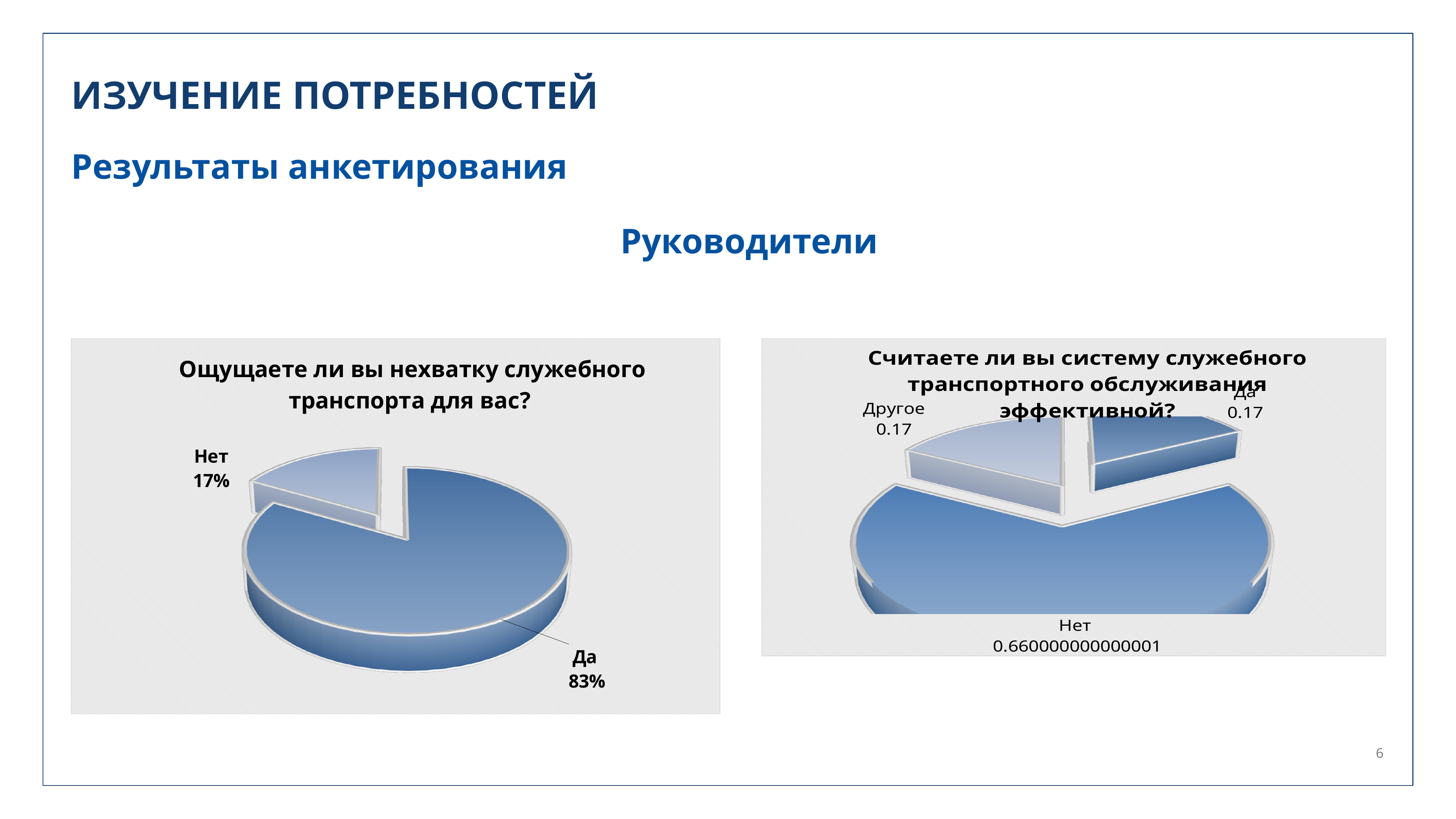
How many slices does the right pie chart have? 3 In the right chart, which slice is the largest? Нет What is the title of the left chart? Ощущаете ли вы нехватку служебного транспорта для вас? How many slices does the left pie chart have? 2 In the right chart ("Считаете ли вы систему служебного транспортного обслуживания эффективной?"), what value is labelled for "Другое"? 0.17 In the left chart ("Ощущаете ли вы нехватку служебного транспорта для вас?"), what share is labelled for "Нет"? 17% What type of chart is the left chart on the slide? Pie chart In the left chart ("Ощущаете ли вы нехватку служебного транспорта для вас?"), what share is labelled for "Да"? 83% In the right chart ("Считаете ли вы систему служебного транспортного обслуживания эффективной?"), what value is labelled for "Нет"? 0.660000000000001 In the left chart, which slice is the largest? Да In the right chart, which is larger: the "Нет" slice or the "Да" slice? Нет In the left chart, what is the difference between the "Да" and "Нет" shares? 66%